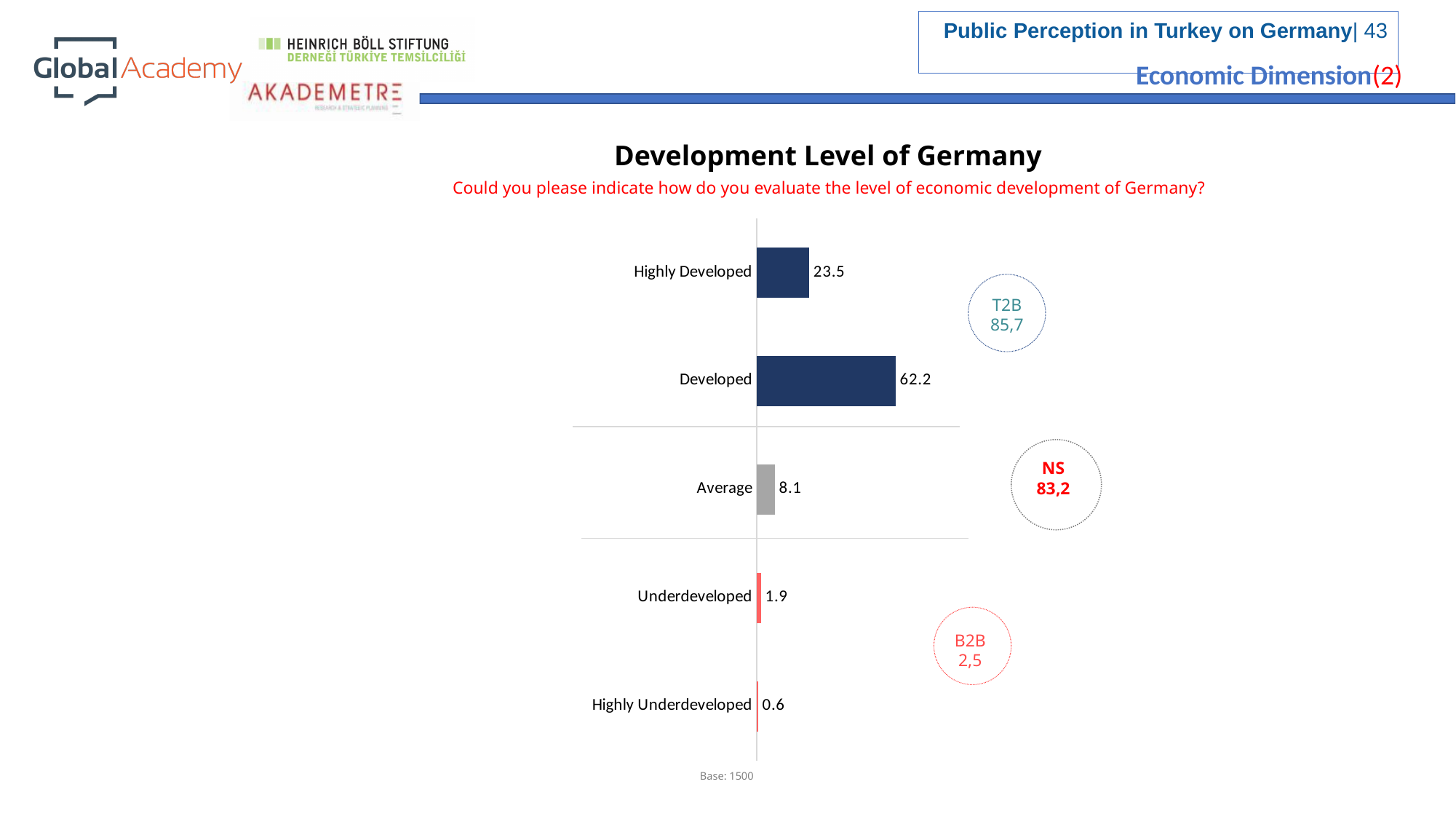
What is the title of the chart? Development Level of Germany Which category has the lowest value? Highly Underdeveloped What is the value for Average? 8.1 What is the value for Highly Underdeveloped? 0.6 What is the value for Highly Developed? 23.5 What is the value for Underdeveloped? 1.9 How many categories are shown in the chart? 5 What kind of chart is shown on the slide? Bar chart What is the difference between the values for Developed and Highly Developed? 38.7 Which category has the highest value? Developed Which is larger, the value for Average or the value for Underdeveloped? Average What is the value for Developed? 62.2